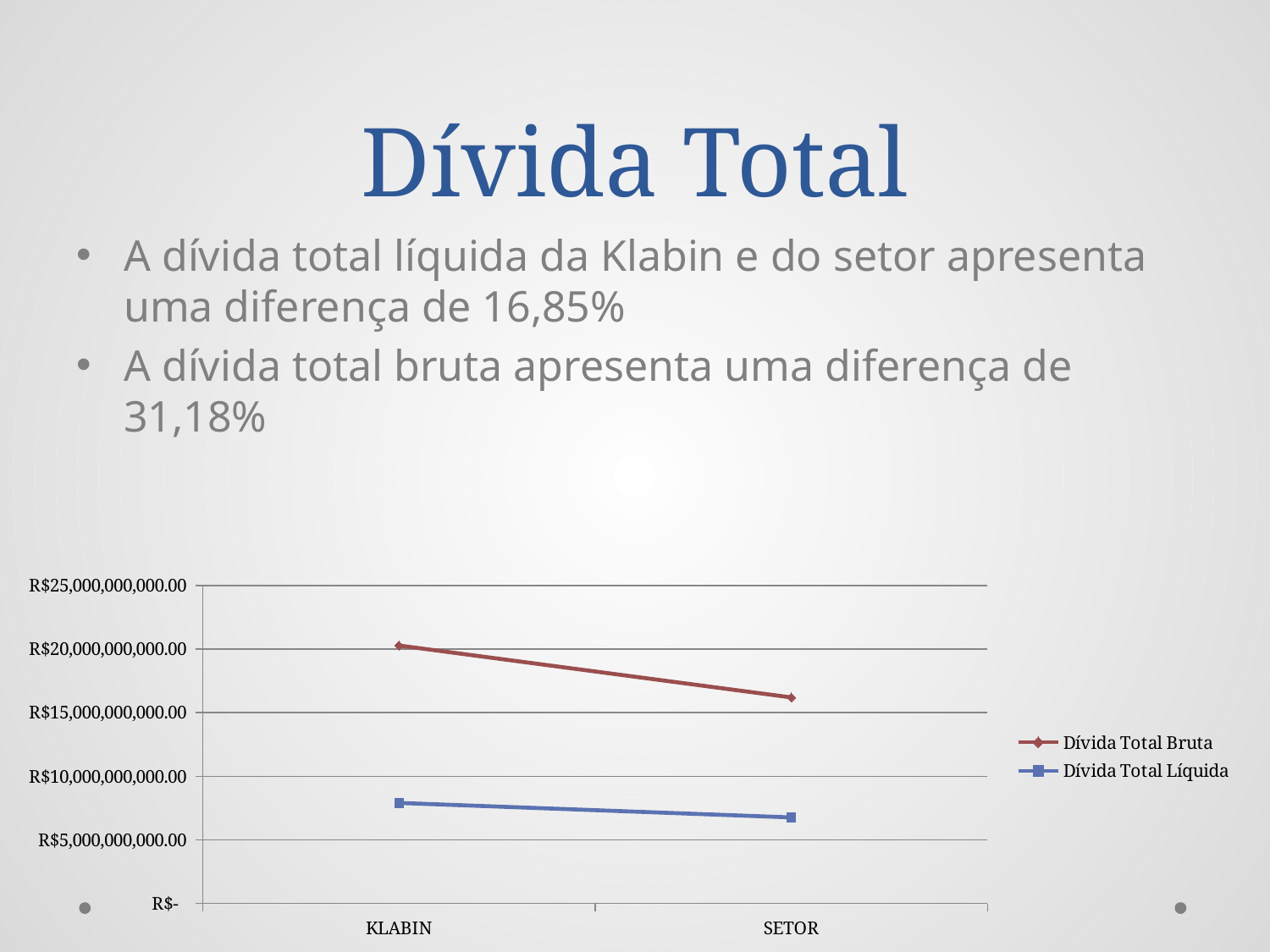
Does the Dívida Total Bruta series rise or fall from KLABIN to SETOR? fall Is the Dívida Total Líquida value for SETOR greater or less than R$5,000,000,000.00? greater Which series is shown in red in the chart? Dívida Total Bruta For KLABIN, which is larger: Dívida Total Bruta or Dívida Total Líquida? Dívida Total Bruta How many categories are shown on the x axis of the chart? 2 How many series does the chart legend list? 2 Does the Dívida Total Líquida series rise or fall from KLABIN to SETOR? fall Is the Dívida Total Líquida value for KLABIN greater or less than R$10,000,000,000.00? less What kind of chart is shown on the slide? line chart Which category has the highest value for Dívida Total Bruta? KLABIN Which category has the lowest value for Dívida Total Líquida? SETOR